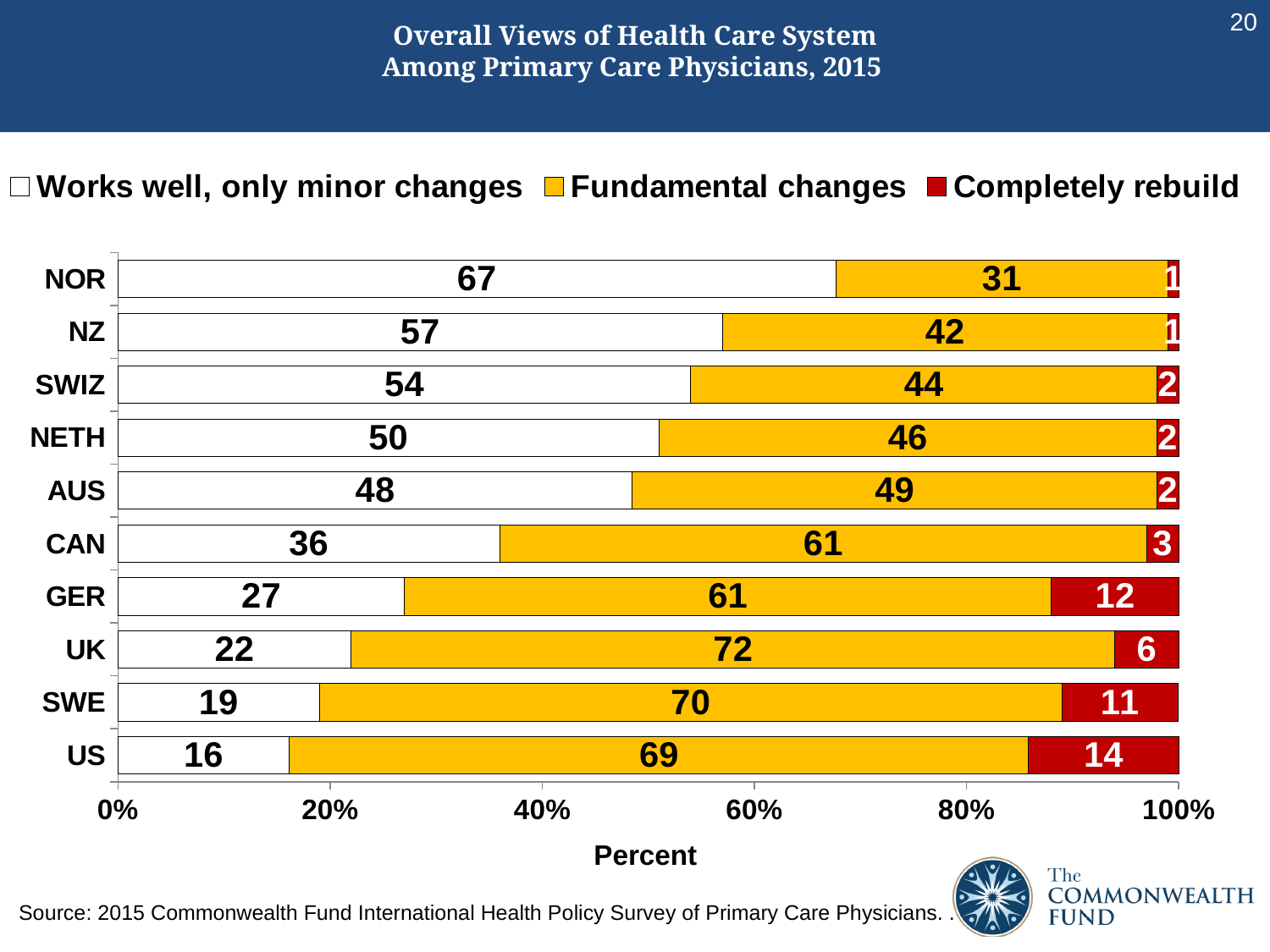
What is the value for 'Completely rebuild' for US? 14 What is the total of the stacked bar for GER? 100 What kind of chart is shown on the slide? Stacked bar chart Which country has the highest value for 'Works well, only minor changes'? NOR Which country has the highest value for 'Completely rebuild'? US What is the value for 'Works well, only minor changes' for NOR? 67 How many series does the legend list? 3 What is the value for 'Fundamental changes' for UK? 72 What is the difference between the 'Fundamental changes' values for UK and NOR? 41 Which is larger, the 'Works well, only minor changes' value for CAN or for GER? CAN Which country has the lowest value for 'Works well, only minor changes'? US How many countries are shown in the chart? 10